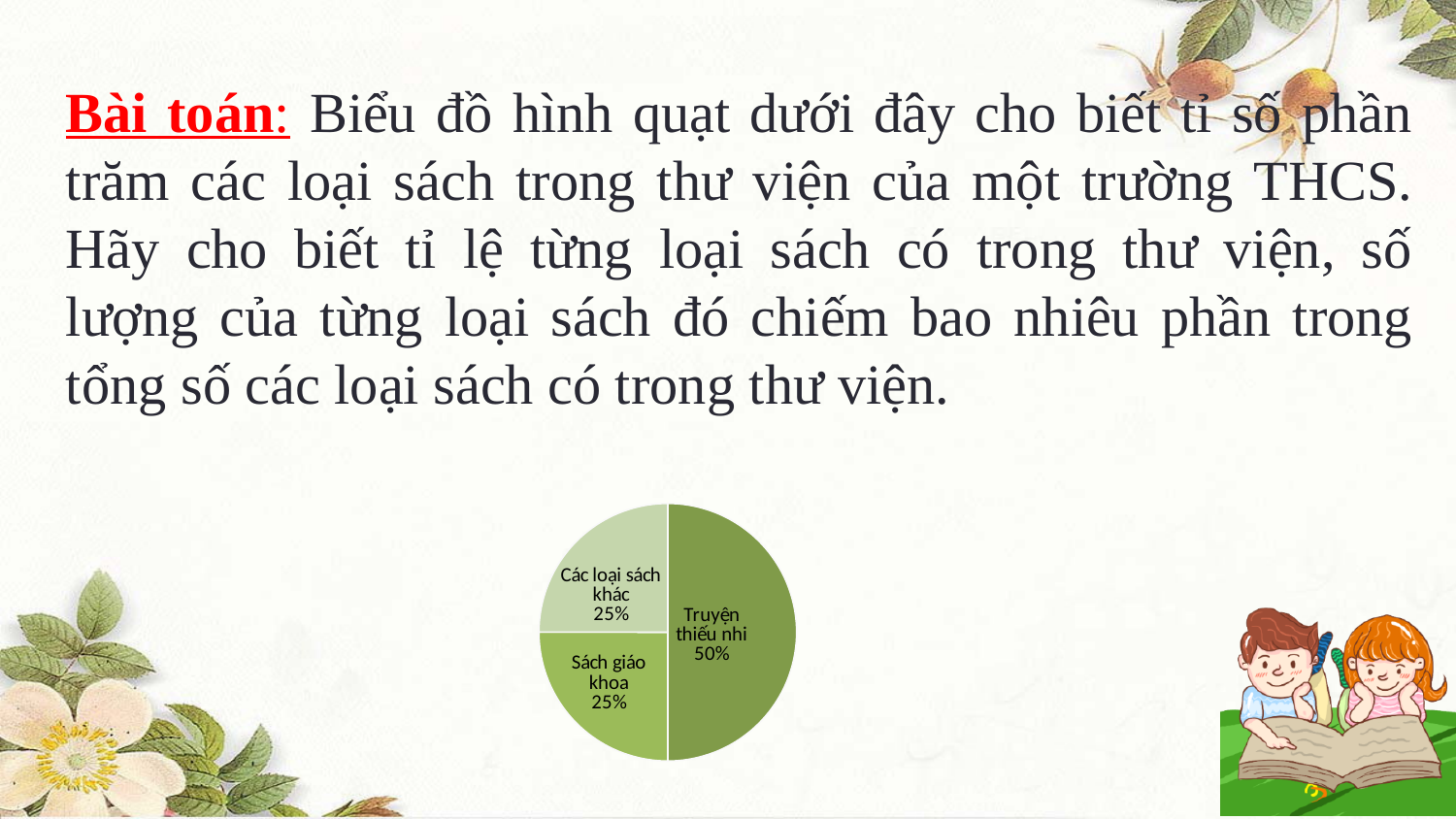
What share of the pie do Sách giáo khoa and Các loại sách khác make up together? 50% Which slice of the pie is the darkest green? Truyện thiếu nhi How many slices does the pie chart have? 3 What is the difference in percentage points between Truyện thiếu nhi and Sách giáo khoa? 25 What percentage of the pie is Sách giáo khoa? 25% What kind of chart is shown on the slide? pie chart What percentage of the pie is Truyện thiếu nhi? 50% Which category has the largest slice of the pie? Truyện thiếu nhi Which is larger, the slice for Truyện thiếu nhi or the slice for Các loại sách khác? Truyện thiếu nhi What percentage of the pie is Các loại sách khác? 25%